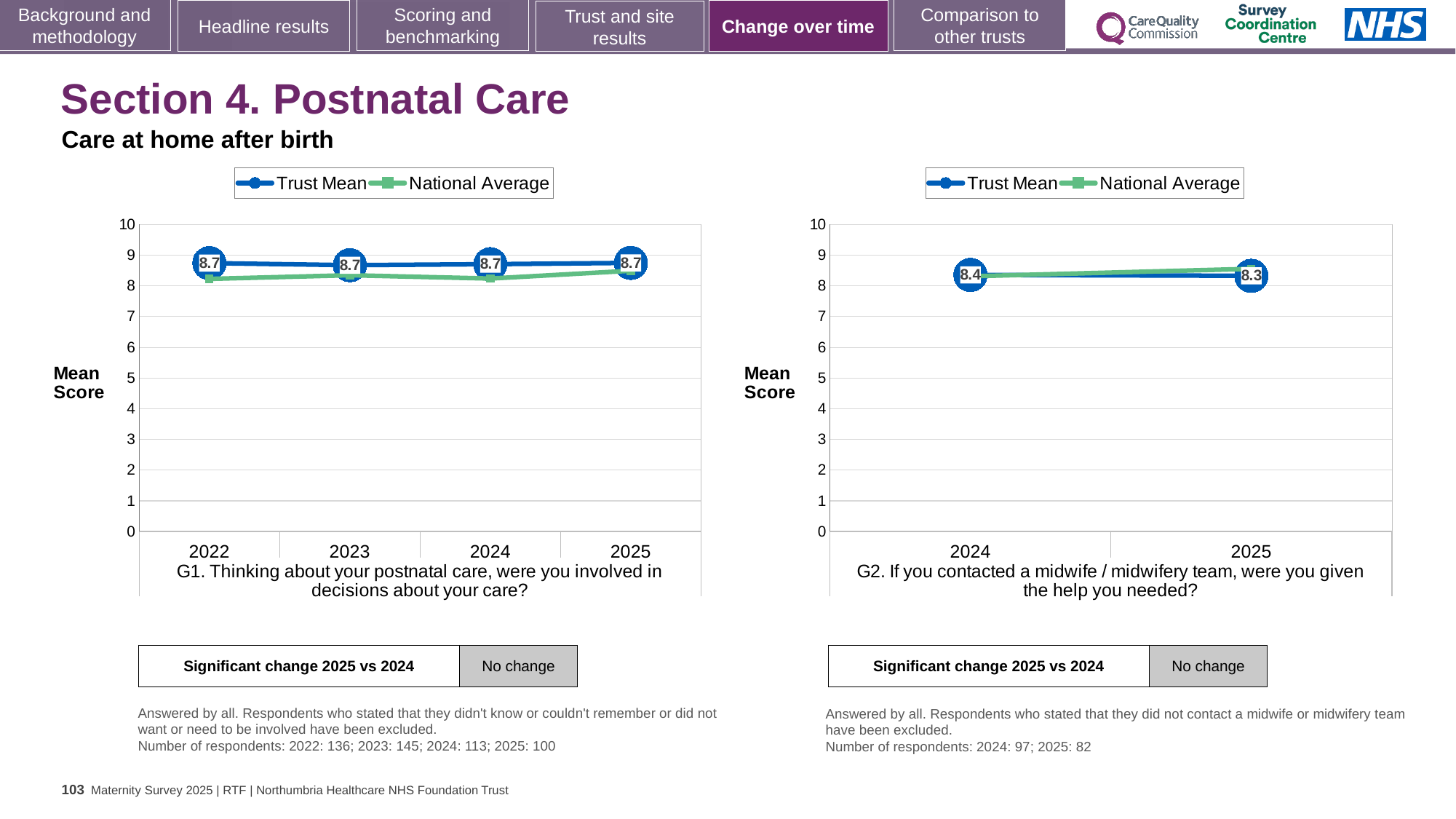
How many series does the legend of the left chart (G1) list? 2 In the right chart (G2), what is the Trust Mean for 2024? 8.4 In the right chart (G2), what is the Trust Mean for 2025? 8.3 In the left chart (G1), how many years are shown on the x axis? 4 In the right chart (G2), how many years are shown on the x axis? 2 What type of chart is the left chart (G1)? Line chart In the left chart (G1), what is the Trust Mean for 2022? 8.7 In the right chart (G2), which year has the higher Trust Mean, 2024 or 2025? 2024 In the right chart (G2), what is the difference between the Trust Mean for 2024 and 2025? 0.1 In the left chart (G1), does the Trust Mean rise, fall or stay flat from 2022 to 2025? Stays flat In the left chart (G1), what is the Trust Mean for 2025? 8.7 In the left chart (G1), is the National Average for 2022 greater or less than 9? less